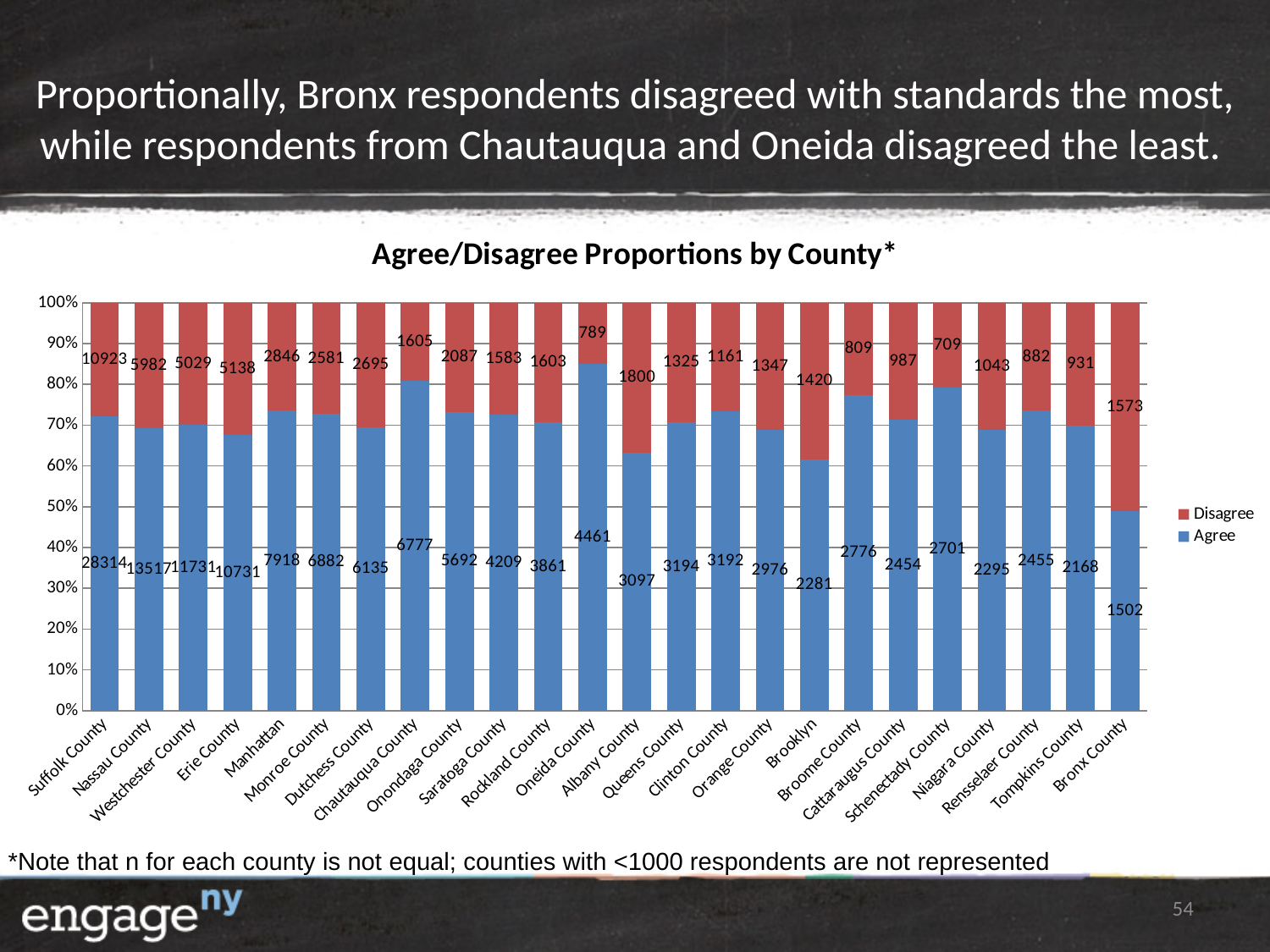
How many counties are shown on the x axis of the chart? 24 What is the Disagree value labelled for Oneida County? 789 How many series does the legend list? 2 What is the difference between the Disagree values for Erie County and Westchester County? 109 What is the Agree value labelled for Suffolk County? 28314 Which county has the highest labelled Agree value? Suffolk County What type of chart is shown on the slide? Stacked bar chart Which county has the lowest labelled Disagree value? Schenectady County What is the title of the chart? Agree/Disagree Proportions by County* What is the total of the Agree and Disagree values for Bronx County? 3075 Which is larger, the Agree value for Chautauqua County or the Agree value for Dutchess County? Chautauqua County